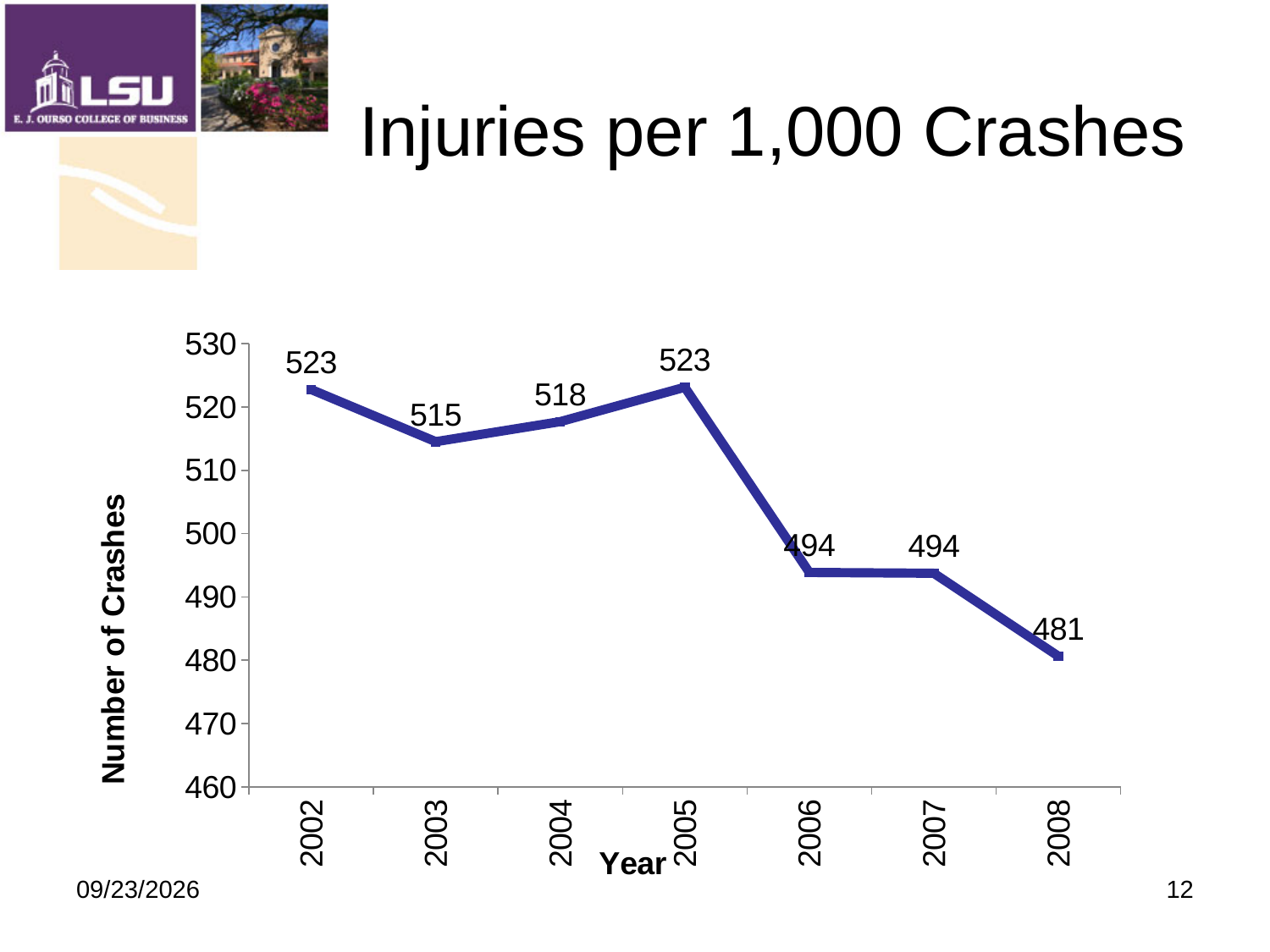
Which year has the lowest value? 2008 Do the values generally rise or fall from 2005 to 2008? fall What is the value for 2003? 515 What is the difference between the values for 2005 and 2006? 29 How many years are plotted on the chart? 7 What is the title of the chart? Injuries per 1,000 Crashes What is the label of the y axis? Number of Crashes What kind of chart is shown? line chart What is the value for 2004? 518 What is the value for 2008? 481 What is the difference between the values for 2002 and 2008? 42 Which is larger, the value for 2003 or the value for 2007? 2003